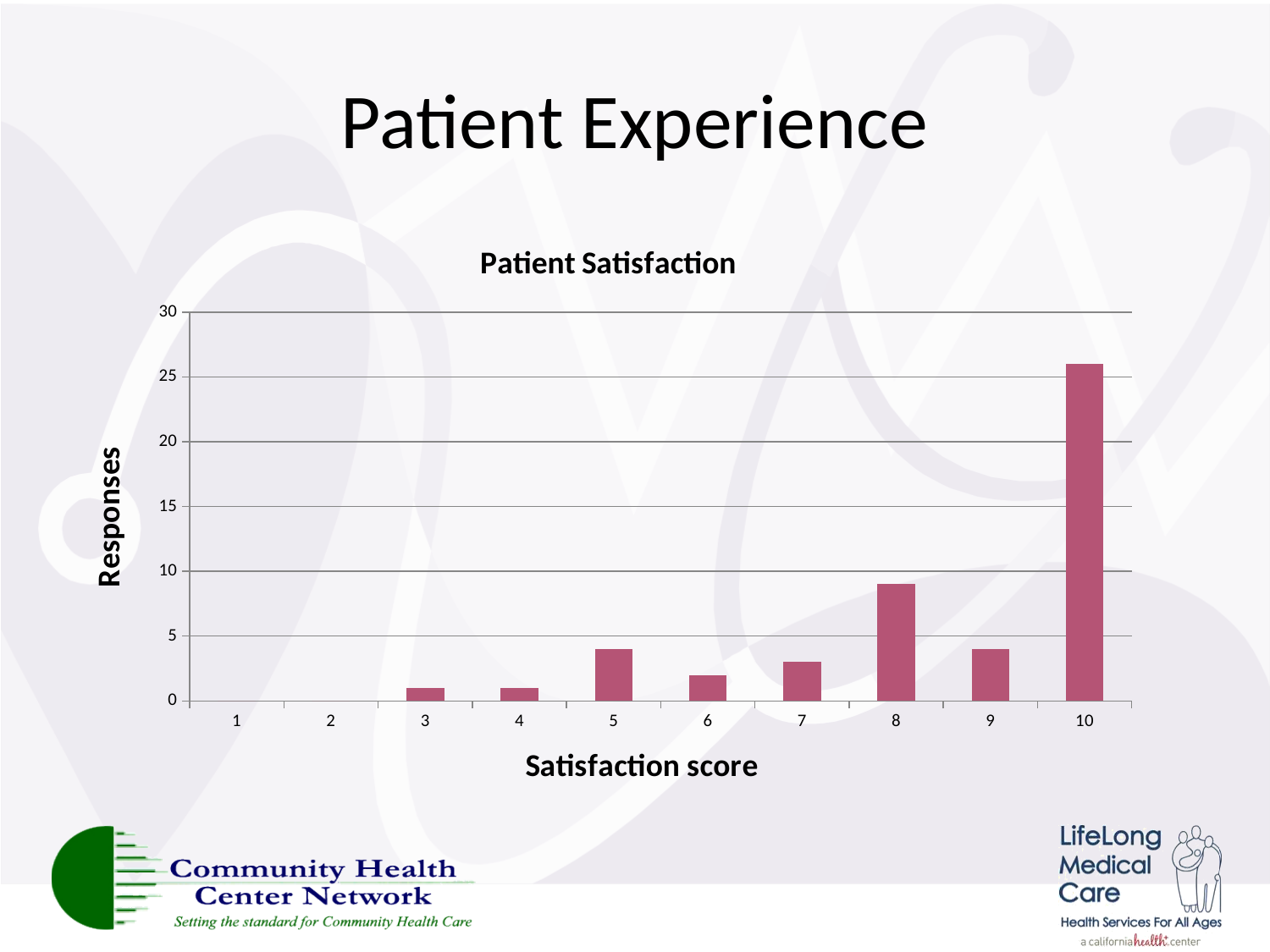
What is the title of the chart? Patient Satisfaction Which has more responses, satisfaction score 8 or satisfaction score 9? 8 Do the responses generally rise or fall as the satisfaction score increases from 1 to 10? rise Is the number of responses for satisfaction score 10 greater or less than 25? greater What kind of chart is shown on the slide? bar chart How many satisfaction score categories are shown on the x axis? 10 Is the number of responses for satisfaction score 6 greater or less than 5? less Which has more responses, satisfaction score 10 or satisfaction score 8? 10 Is the number of responses for satisfaction score 8 greater or less than 5? greater Which satisfaction score received the most responses? 10 What is the label of the vertical axis? Responses